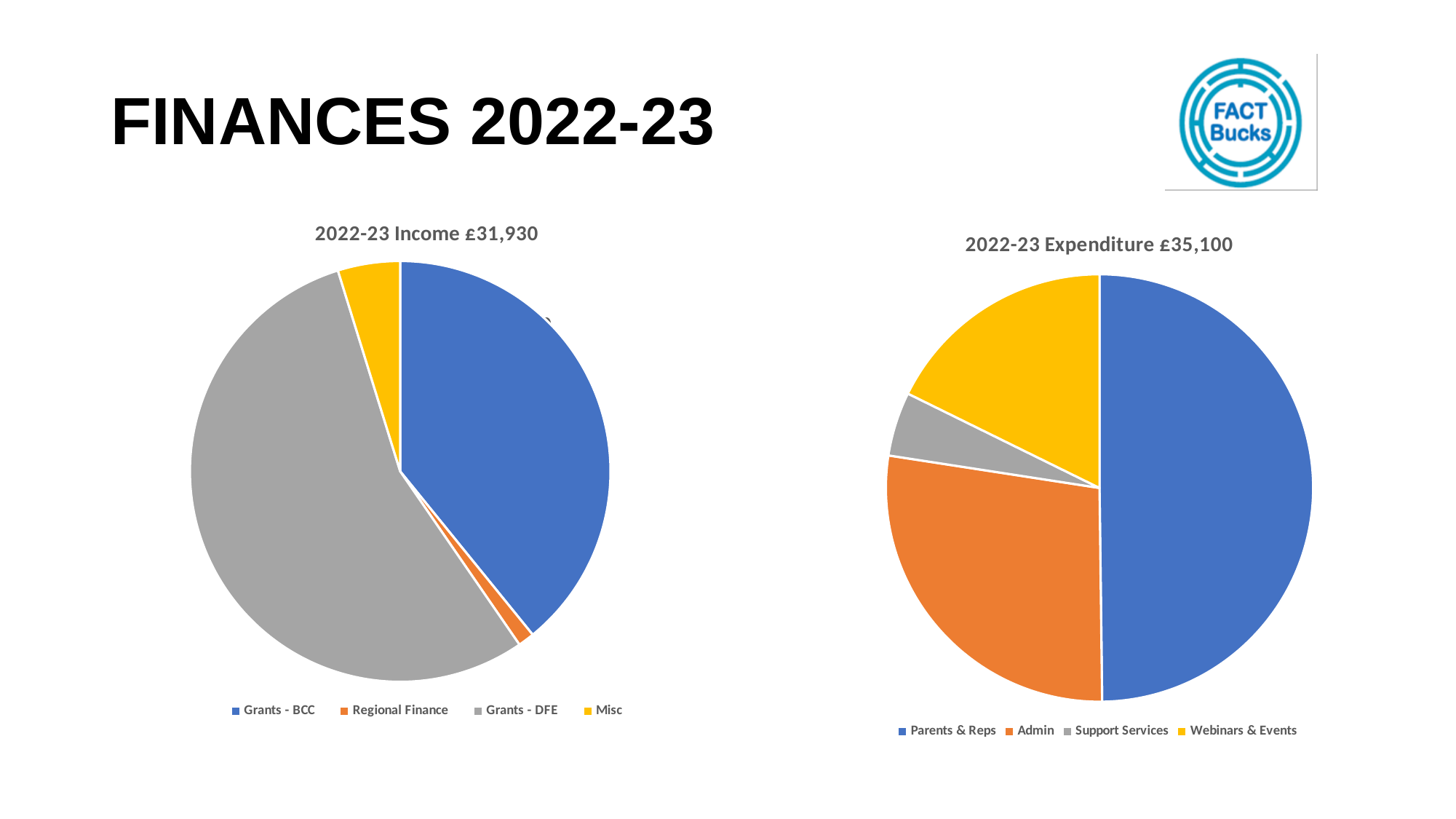
How many categories does the legend of the 2022-23 Expenditure chart list? 4 In the 2022-23 Expenditure chart, which category has the largest slice? Parents & Reps In the 2022-23 Income chart, which category has the largest slice? Grants - DFE In the 2022-23 Expenditure chart, which is larger: Admin or Webinars & Events? Admin What kind of chart is the 2022-23 Income chart on the left? Pie chart What total expenditure is stated in the title of the right chart? £35,100 In the 2022-23 Income chart, which is larger: Grants - BCC or Misc? Grants - BCC In the 2022-23 Expenditure chart, which category has the smallest slice? Support Services What total income is stated in the title of the left chart? £31,930 By how much does the total expenditure (£35,100) exceed the total income (£31,930) according to the chart titles? £3,170 How many categories does the legend of the 2022-23 Income chart list? 4 In the 2022-23 Income chart, which category has the smallest slice? Regional Finance